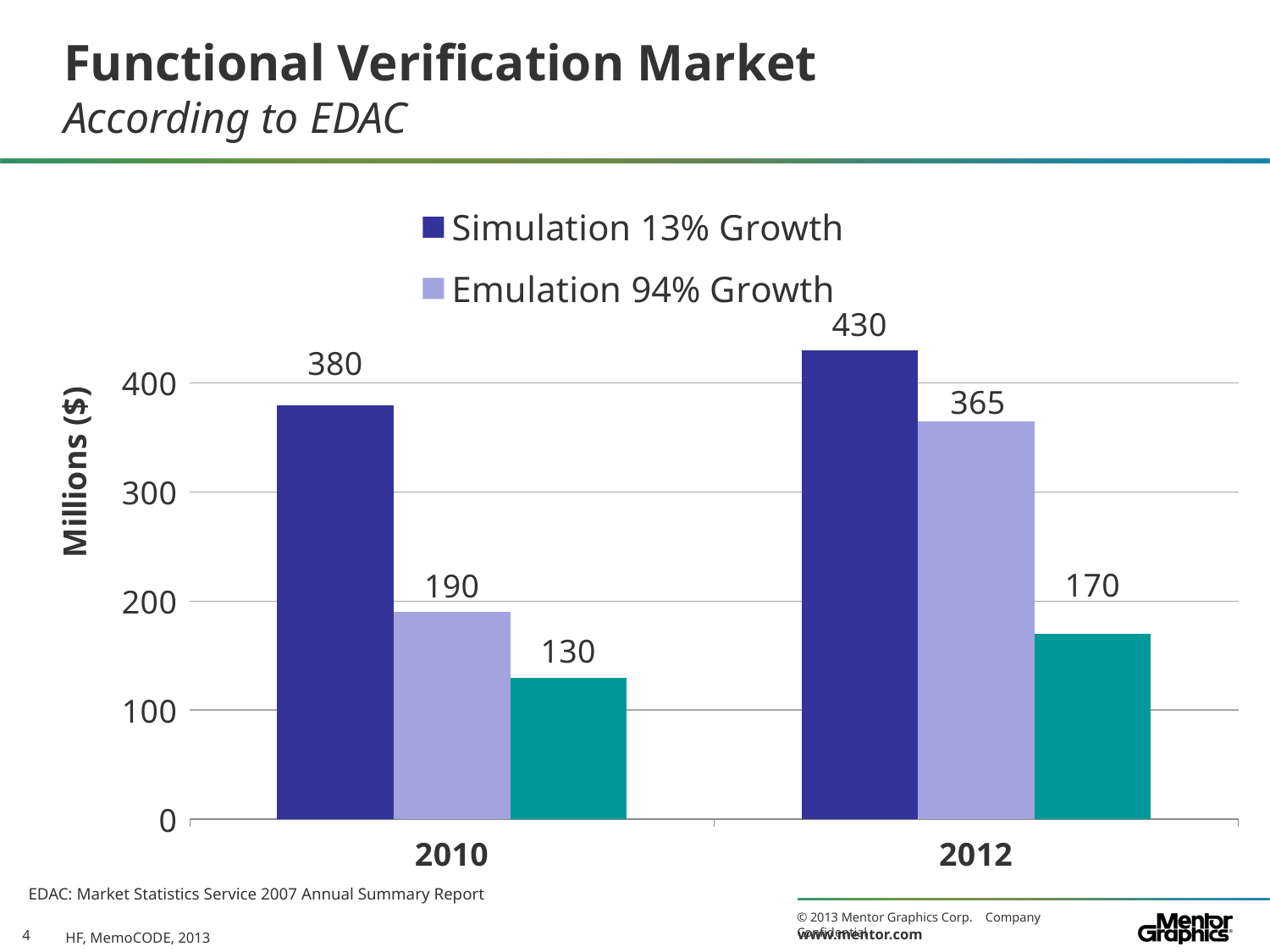
How many years are shown on the x axis? 2 What is the difference between the Simulation 13% Growth values for 2012 and 2010? 50 Which is larger in 2012: Simulation 13% Growth or Emulation 94% Growth? Simulation 13% Growth What is the difference between the Emulation 94% Growth values for 2012 and 2010? 175 What kind of chart is shown on the slide? Bar chart What is the value for Simulation 13% Growth in 2010? 380 What is the value for Emulation 94% Growth in 2010? 190 In which year is the Emulation 94% Growth value lowest? 2010 What is the value for Simulation 13% Growth in 2012? 430 In which year is the Simulation 13% Growth value highest? 2012 What is the value for Emulation 94% Growth in 2012? 365 How many series does the legend list? 2